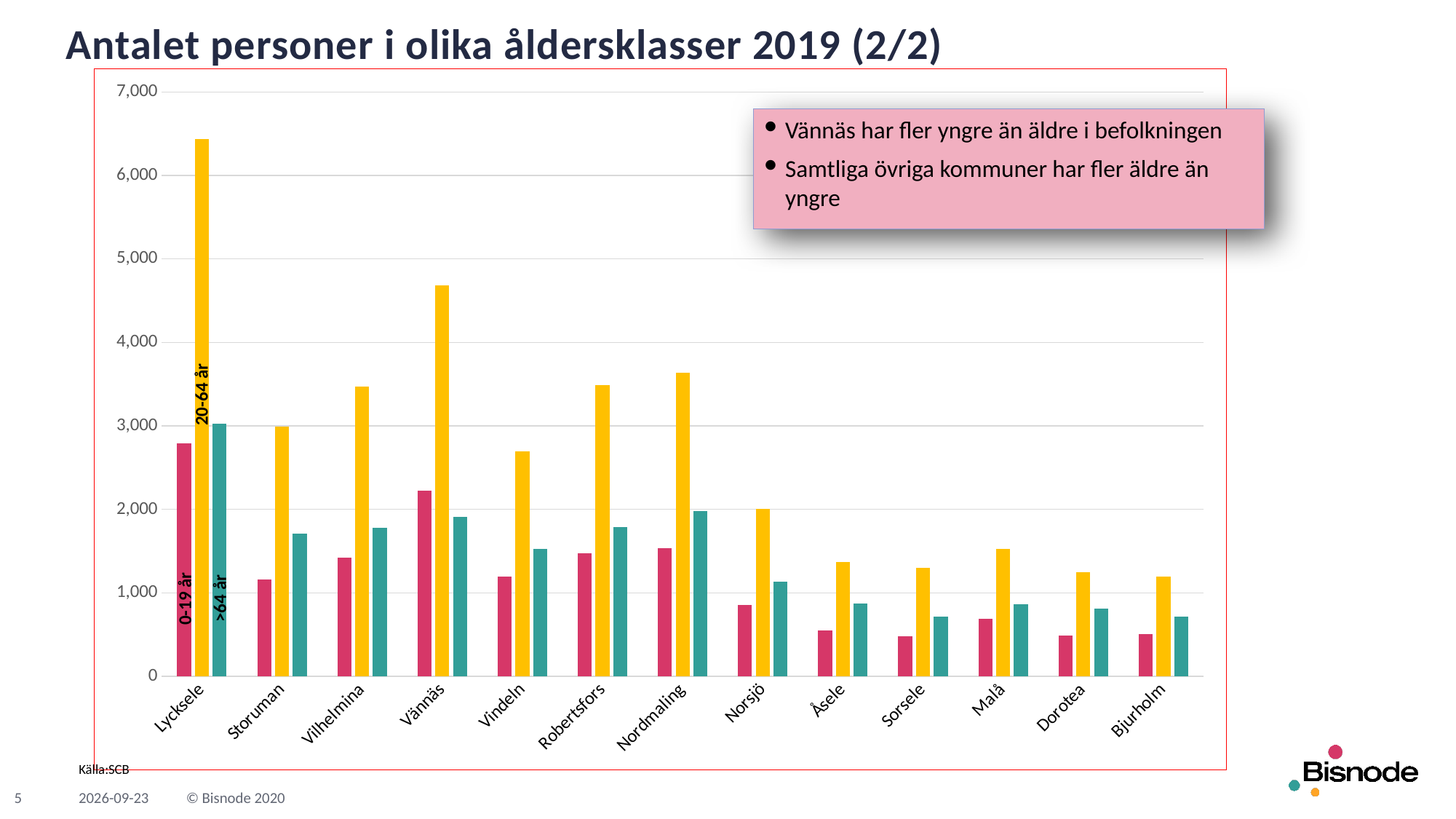
For Vännäs, which is larger: the 0-19 år value or the >64 år value? 0-19 år Is the 20-64 år value for Lycksele greater or less than 6,000? greater Is the 20-64 år value for Nordmaling greater or less than 3,000? greater What is the title of the chart on the slide? Antalet personer i olika åldersklasser 2019 (2/2) Which municipality has the highest value for the >64 år series? Lycksele Is the 0-19 år value for Norsjö greater or less than 1,000? less Which municipality has the highest value for the 20-64 år series? Lycksele How many age-group series are plotted in the chart? 3 What kind of chart is shown on the slide? bar chart For Lycksele, which is larger: the 0-19 år value or the >64 år value? >64 år How many municipalities are shown on the x axis of the chart? 13